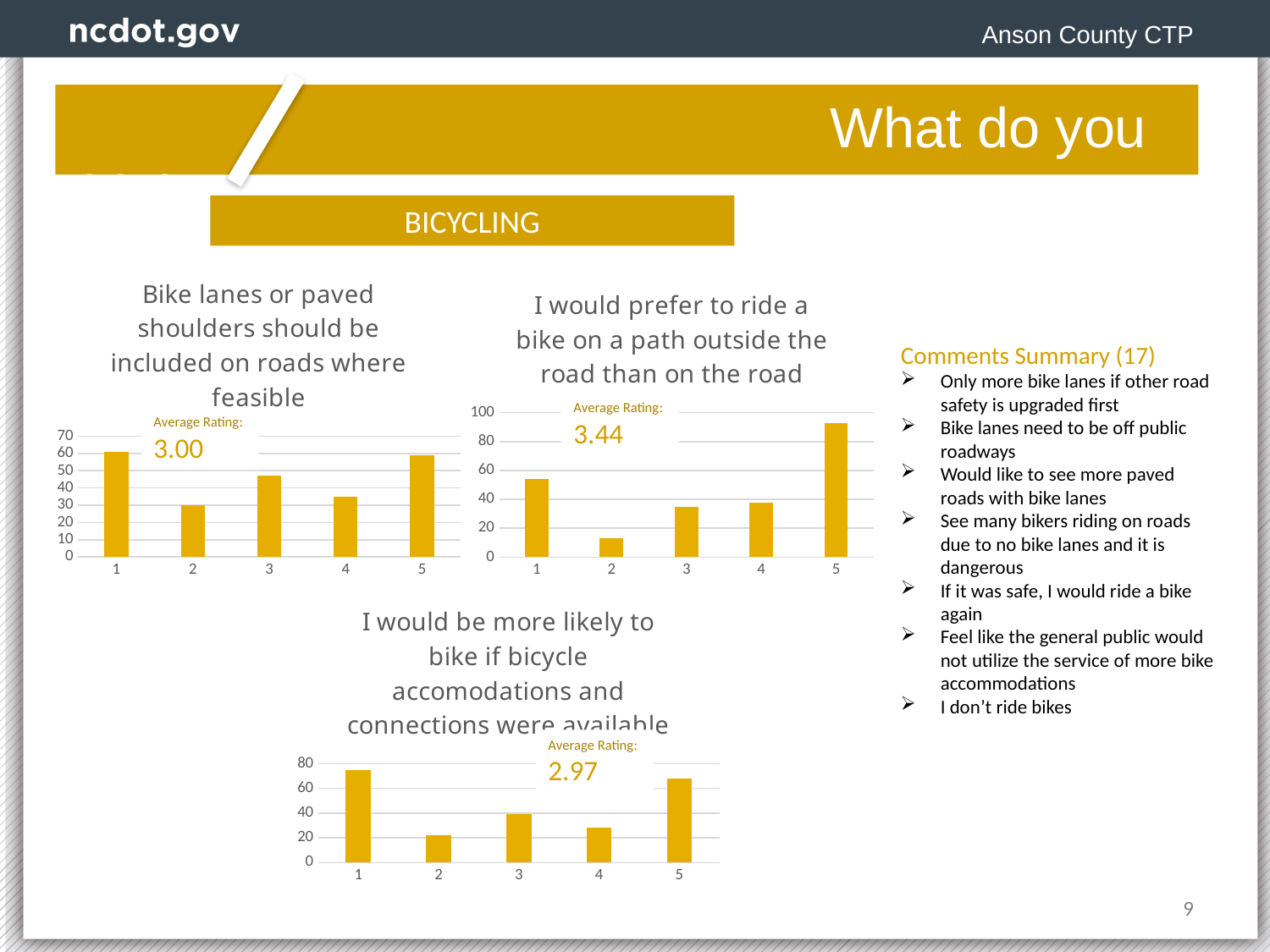
In the chart titled "I would be more likely to bike if bicycle accomodations and connections were available", is the value for rating 3 greater or less than 60? less In the chart titled "I would prefer to ride a bike on a path outside the road than on the road", which rating category has the highest bar? 5 In the chart titled "Bike lanes or paved shoulders should be included on roads where feasible", is the value for rating 1 greater or less than 50? greater In the chart titled "I would be more likely to bike if bicycle accomodations and connections were available", what is the average rating shown? 2.97 How many rating categories are shown on the x axis of the chart titled "I would be more likely to bike if bicycle accomodations and connections were available"? 5 In the chart titled "I would prefer to ride a bike on a path outside the road than on the road", which rating category has the lowest bar? 2 In the chart titled "I would prefer to ride a bike on a path outside the road than on the road", is the value for rating 2 greater or less than 20? less In the chart titled "I would prefer to ride a bike on a path outside the road than on the road", what is the average rating shown? 3.44 In the chart titled "Bike lanes or paved shoulders should be included on roads where feasible", which is larger, the value for rating 3 or the value for rating 2? rating 3 In the chart titled "I would be more likely to bike if bicycle accomodations and connections were available", which rating category has the highest bar? 1 In the chart titled "Bike lanes or paved shoulders should be included on roads where feasible", what is the average rating shown? 3.00